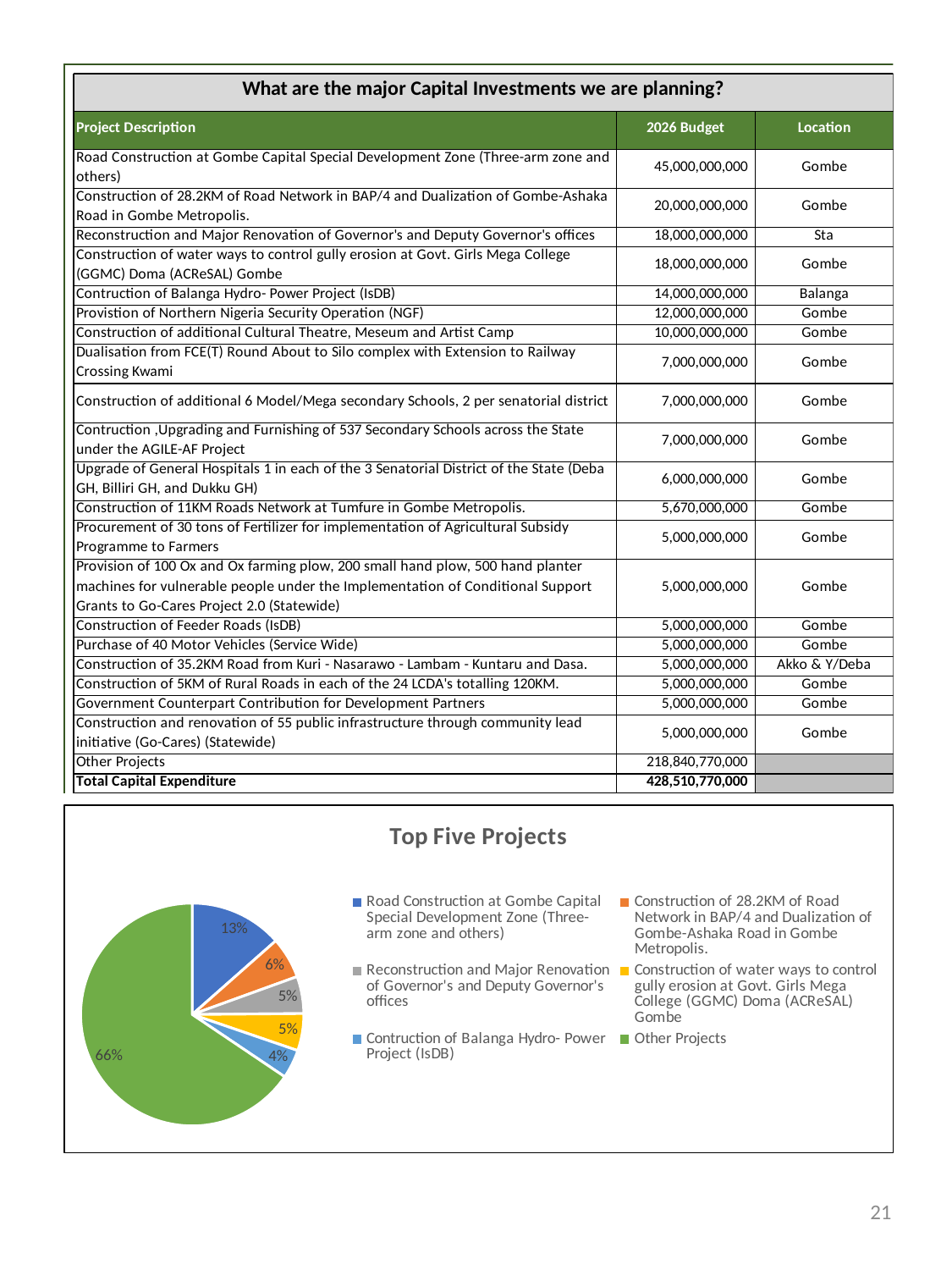
In the Top Five Projects pie chart, which slice is the largest? Other Projects In the Top Five Projects pie chart, what share is shown for Contruction of Balanga Hydro- Power Project (IsDB)? 4% In the Top Five Projects pie chart, what colour is the Other Projects slice? Green In the Top Five Projects pie chart, how many slices are there? 6 In the Top Five Projects pie chart, which is larger: the share for Road Construction at Gombe Capital Special Development Zone or the share for Construction of 28.2KM of Road Network in BAP/4? Road Construction at Gombe Capital Special Development Zone In the Top Five Projects pie chart, what is the difference in percentage points between the Other Projects slice and the Road Construction at Gombe Capital Special Development Zone slice? 53 In the Top Five Projects pie chart, what share is labelled for Other Projects? 66% In the Top Five Projects pie chart, what share is shown for Road Construction at Gombe Capital Special Development Zone (Three-arm zone and others)? 13% What kind of chart is shown under the title "Top Five Projects"? Pie chart In the Top Five Projects pie chart, which slice is the smallest? Contruction of Balanga Hydro- Power Project (IsDB) In the Top Five Projects pie chart, what share is shown for Reconstruction and Major Renovation of Governor's and Deputy Governor's offices? 5% In the Top Five Projects pie chart, what share is shown for Construction of 28.2KM of Road Network in BAP/4 and Dualization of Gombe-Ashaka Road in Gombe Metropolis? 6%